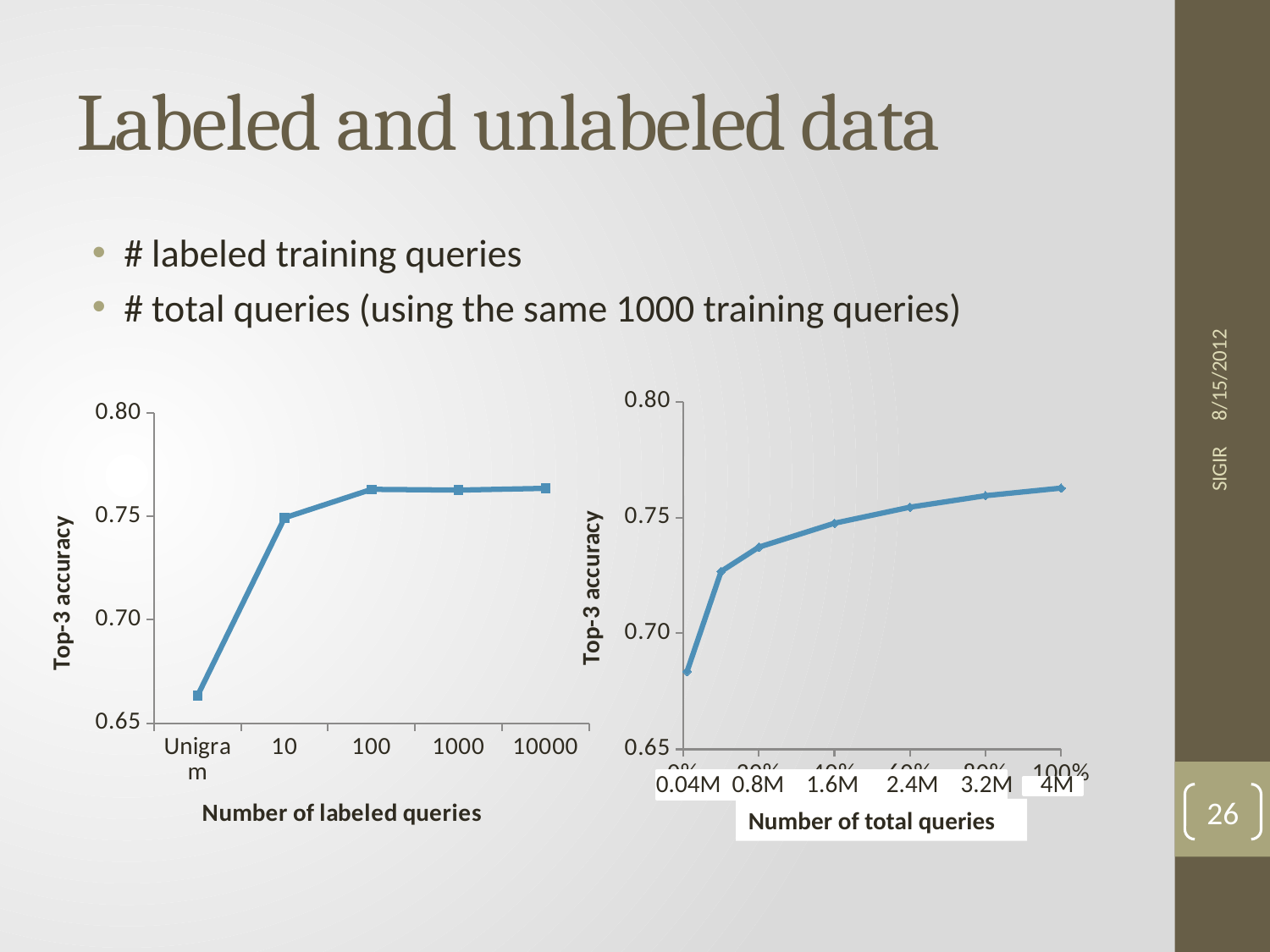
In the right chart, 'Number of total queries', is the Top-3 accuracy at 4M greater or less than 0.75? greater In the right chart, 'Number of total queries', does Top-3 accuracy rise or fall as the number of total queries increases? rise In the left chart, 'Number of labeled queries', how many points are plotted along the x axis? 5 In the right chart, 'Number of total queries', is the Top-3 accuracy at 0.04M greater or less than 0.70? less In the right chart, 'Number of total queries', which has the higher Top-3 accuracy, 0.04M or 4M? 4M In the left chart, 'Number of labeled queries', which x-axis category has the lowest Top-3 accuracy? Unigram In the left chart, 'Number of labeled queries', is the Top-3 accuracy for 100 labeled queries greater or less than 0.75? greater What kind of chart is the left chart, 'Number of labeled queries'? line chart What is the y-axis title of the left chart? Top-3 accuracy In the right chart, 'Number of total queries', how many points are plotted along the x axis? 7 What kind of chart is the right chart, 'Number of total queries'? line chart